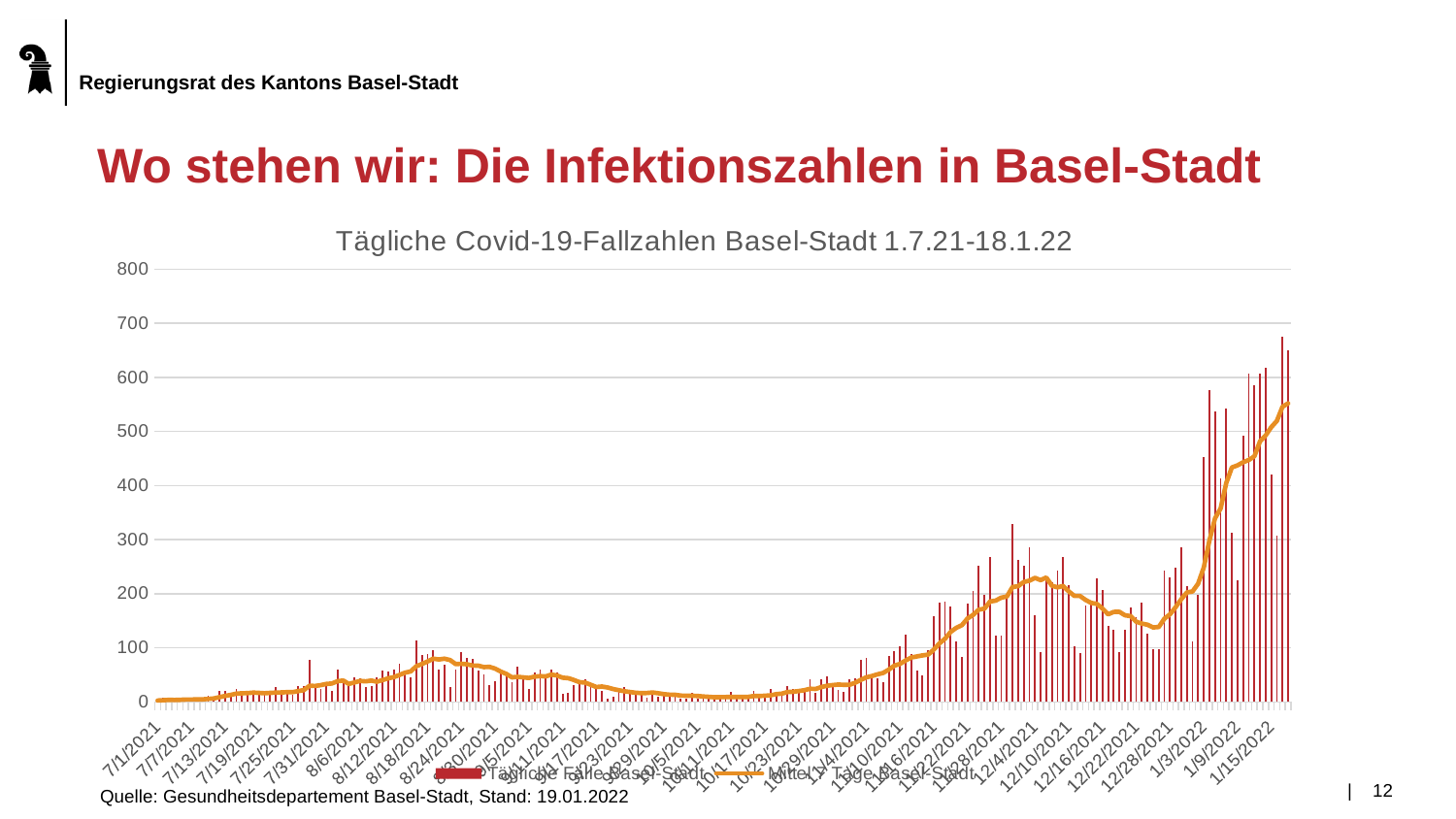
Overall, do the daily case numbers rise or fall from July 2021 to January 2022? Rise What is the title of the chart? Tägliche Covid-19-Fallzahlen Basel-Stadt 1.7.21-18.1.22 Is the 7-day mean line at the end of the chart (mid-January 2022) greater or less than 500? greater In which month do the daily case bars reach their highest values? January 2022 Is the highest daily case bar in January 2022 greater or less than 600? greater Is the 7-day mean line around 8/24/2021 greater or less than 100? less How many series does the chart's legend list? 2 Which is higher: the 7-day mean around 12/4/2021 or the 7-day mean around 10/23/2021? 12/4/2021 What kind of chart is shown on the slide? A bar chart with a line overlay What is the highest value shown on the y axis? 800